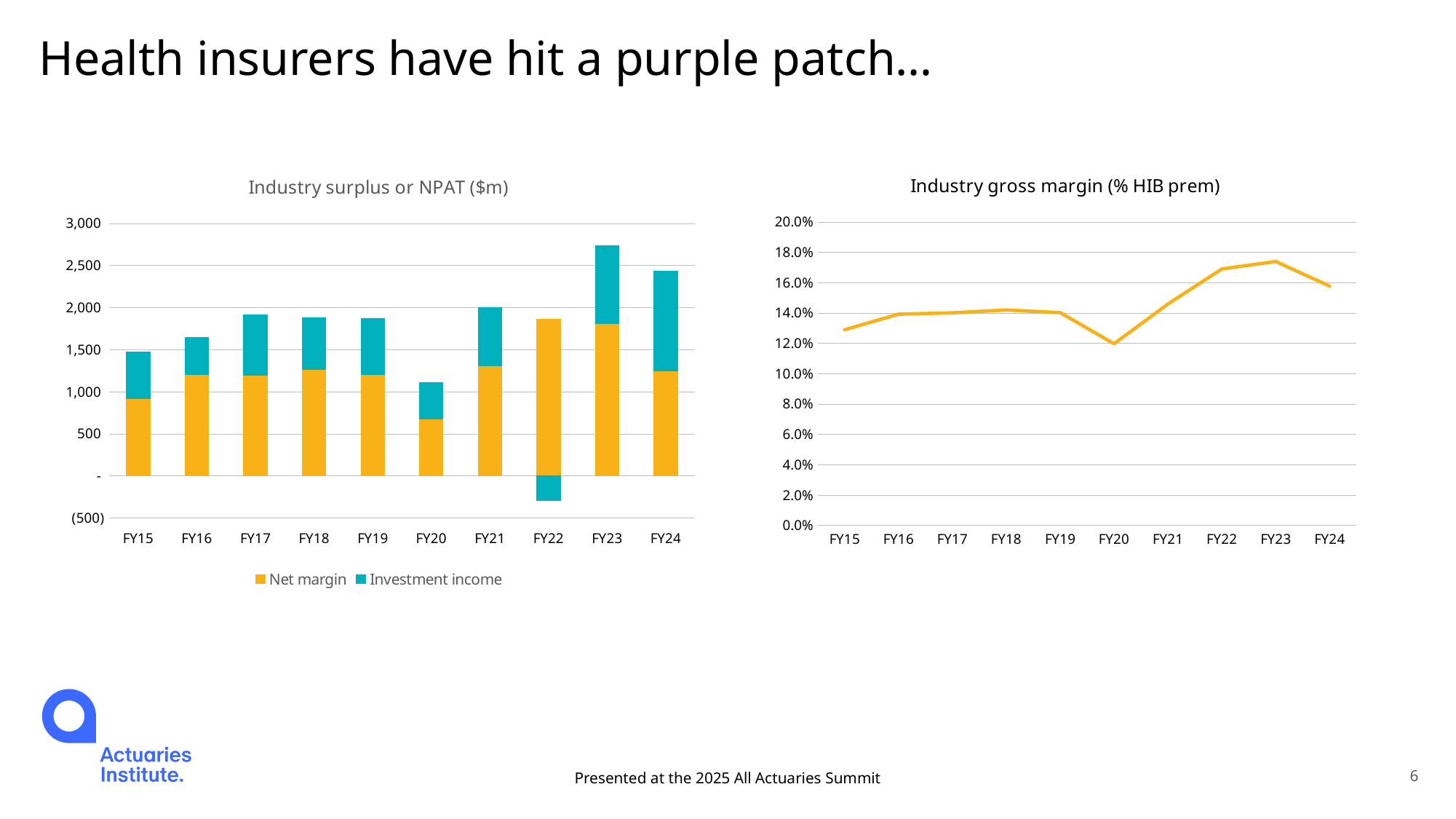
In the 'Industry surplus or NPAT ($m)' chart, how many series does the legend list? 2 In the 'Industry gross margin (% HIB prem)' chart, which year has the lowest gross margin? FY20 In the 'Industry gross margin (% HIB prem)' chart, which year has the highest gross margin? FY23 In the 'Industry gross margin (% HIB prem)' chart, does the gross margin rise or fall from FY20 to FY23? Rise In the 'Industry surplus or NPAT ($m)' chart, is the total of the FY20 bar greater or less than 1,500? less What kind of chart is the 'Industry surplus or NPAT ($m)' chart on the left? Stacked bar chart In the 'Industry surplus or NPAT ($m)' chart, which year shows a negative Investment income value? FY22 In the 'Industry surplus or NPAT ($m)' chart, which year has the tallest stacked bar? FY23 In the 'Industry surplus or NPAT ($m)' chart, how many financial years are shown on the x axis? 10 What kind of chart is the 'Industry gross margin (% HIB prem)' chart on the right? Line chart In the 'Industry surplus or NPAT ($m)' chart, which series is shown in orange? Net margin In the 'Industry surplus or NPAT ($m)' chart, is the total of the FY23 bar greater or less than 2,500? greater